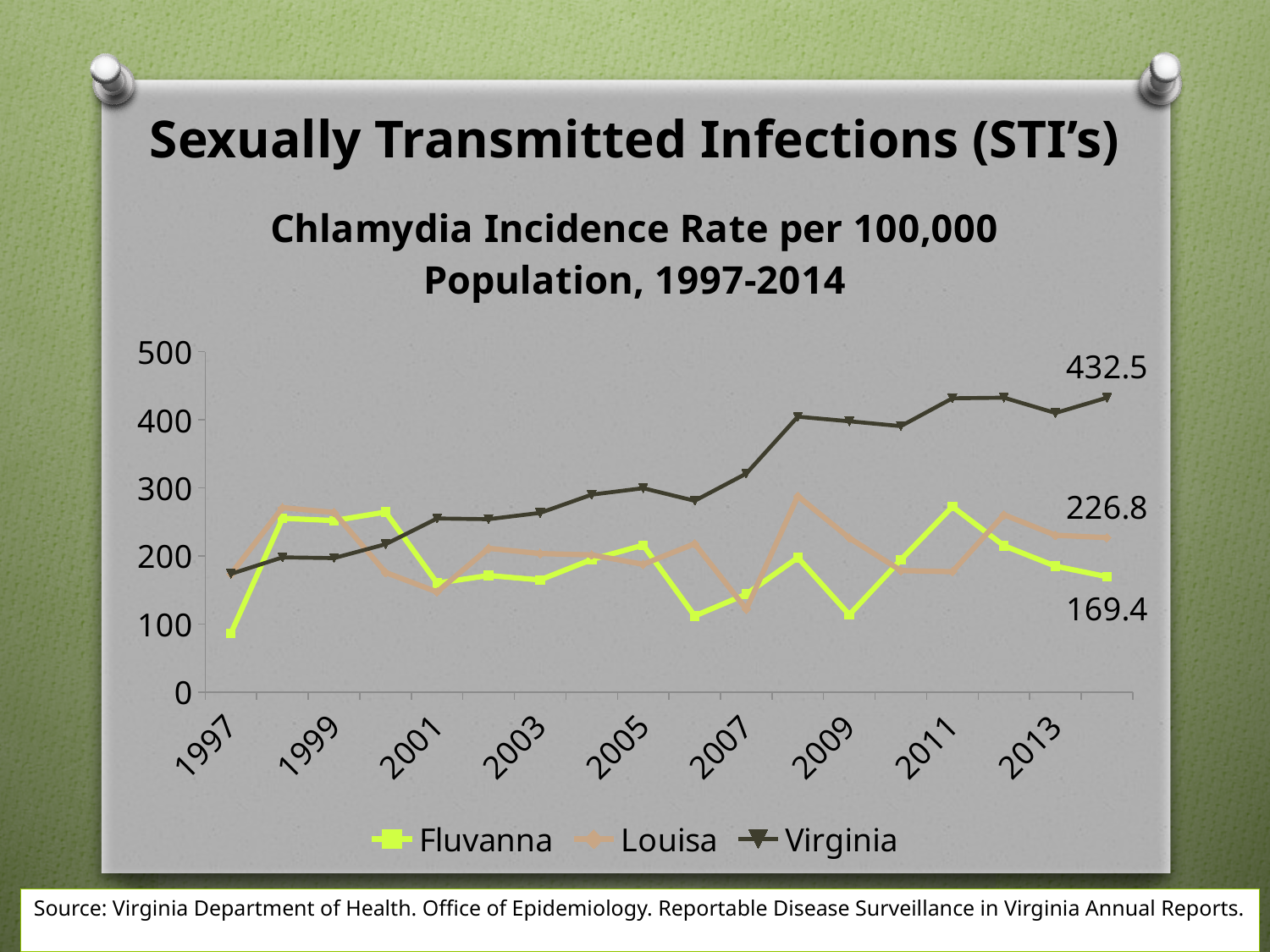
How many series does the legend list? 3 Which series has the highest value in 2014? Virginia What is the difference between the Louisa and Fluvanna rates in 2014? 57.4 Is the value for Virginia in 1997 greater or less than 200? less What is the chlamydia incidence rate for Virginia in 2014? 432.5 What is the difference between the Virginia and Fluvanna rates in 2014? 263.1 What kind of chart is shown on the slide? line chart Is the value for Fluvanna in 1997 greater or less than 100? less What is the chlamydia incidence rate for Louisa in 2014? 226.8 Which is larger in 2014, the Virginia rate or the Louisa rate? Virginia Does the Virginia series generally rise or fall from 1997 to 2014? rise What is the chlamydia incidence rate for Fluvanna in 2014? 169.4